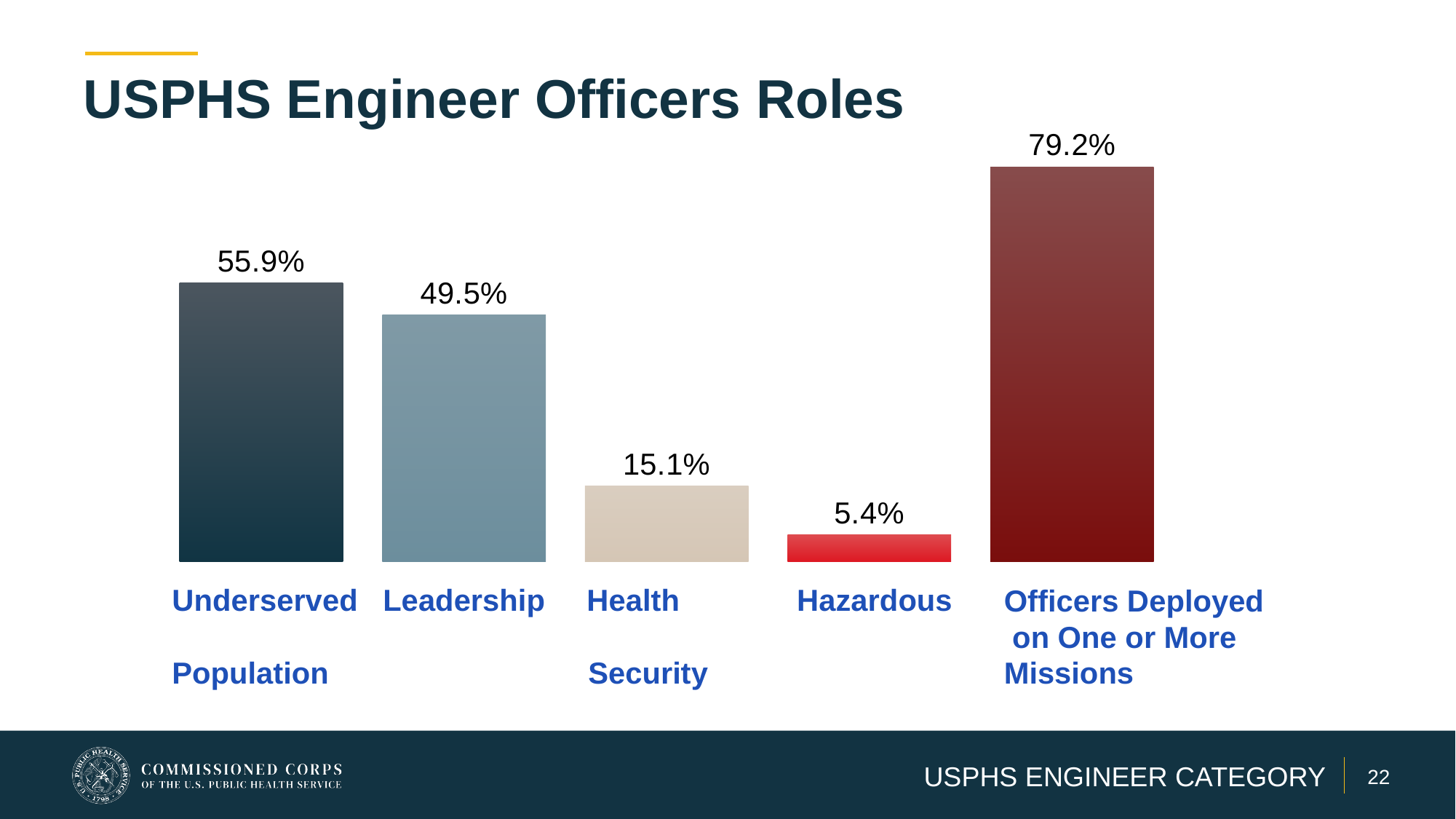
What is the value for Health Security? 15.1% What is the value for Hazardous? 5.4% What kind of chart is shown on the slide? Bar chart What is the value for Underserved Population? 55.9% What is the difference between the values for Underserved Population and Leadership? 6.4% Which is larger, the value for Leadership or the value for Health Security? Leadership How many categories are shown in the chart? 5 Which category has the lowest value? Hazardous What is the difference between the values for Health Security and Hazardous? 9.7% Which category has the highest value? Officers Deployed on One or More Missions What is the value for Officers Deployed on One or More Missions? 79.2% What is the value for Leadership? 49.5%